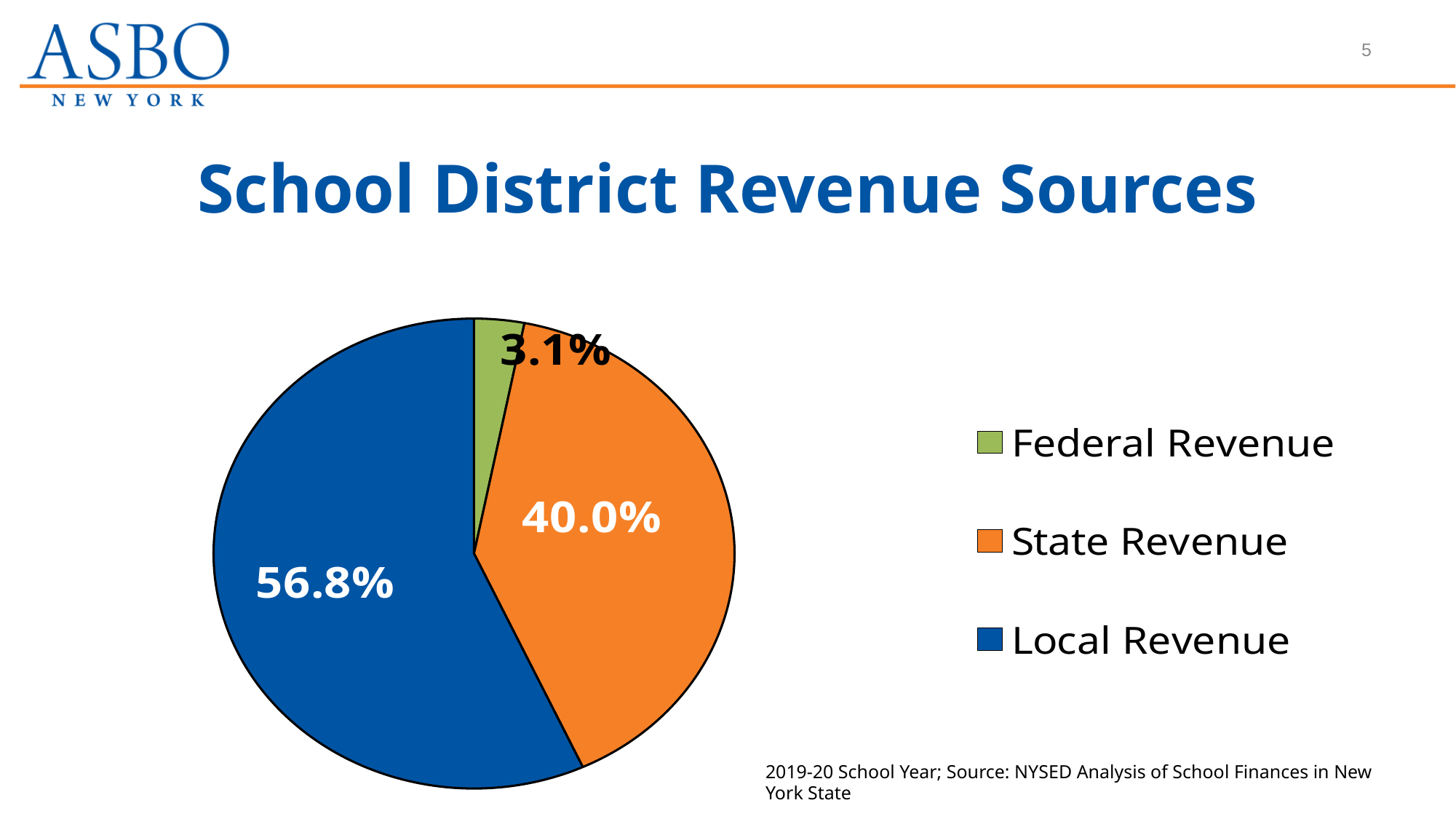
Which colour represents State Revenue in the pie chart? Orange What is the difference in percentage points between State Revenue and Federal Revenue? 36.9 Which revenue source has the smallest share of the pie? Federal Revenue Which revenue source has the largest share of the pie? Local Revenue What is the title of the chart on the slide? School District Revenue Sources Which is larger, the State Revenue share or the Federal Revenue share? State Revenue What type of chart is shown on the slide? Pie chart How many revenue sources are shown in the pie chart? 3 What share of school district revenue comes from State Revenue? 40.0% What is the difference in percentage points between Local Revenue and State Revenue? 16.8 What share of school district revenue comes from Local Revenue? 56.8% What share of school district revenue comes from Federal Revenue? 3.1%